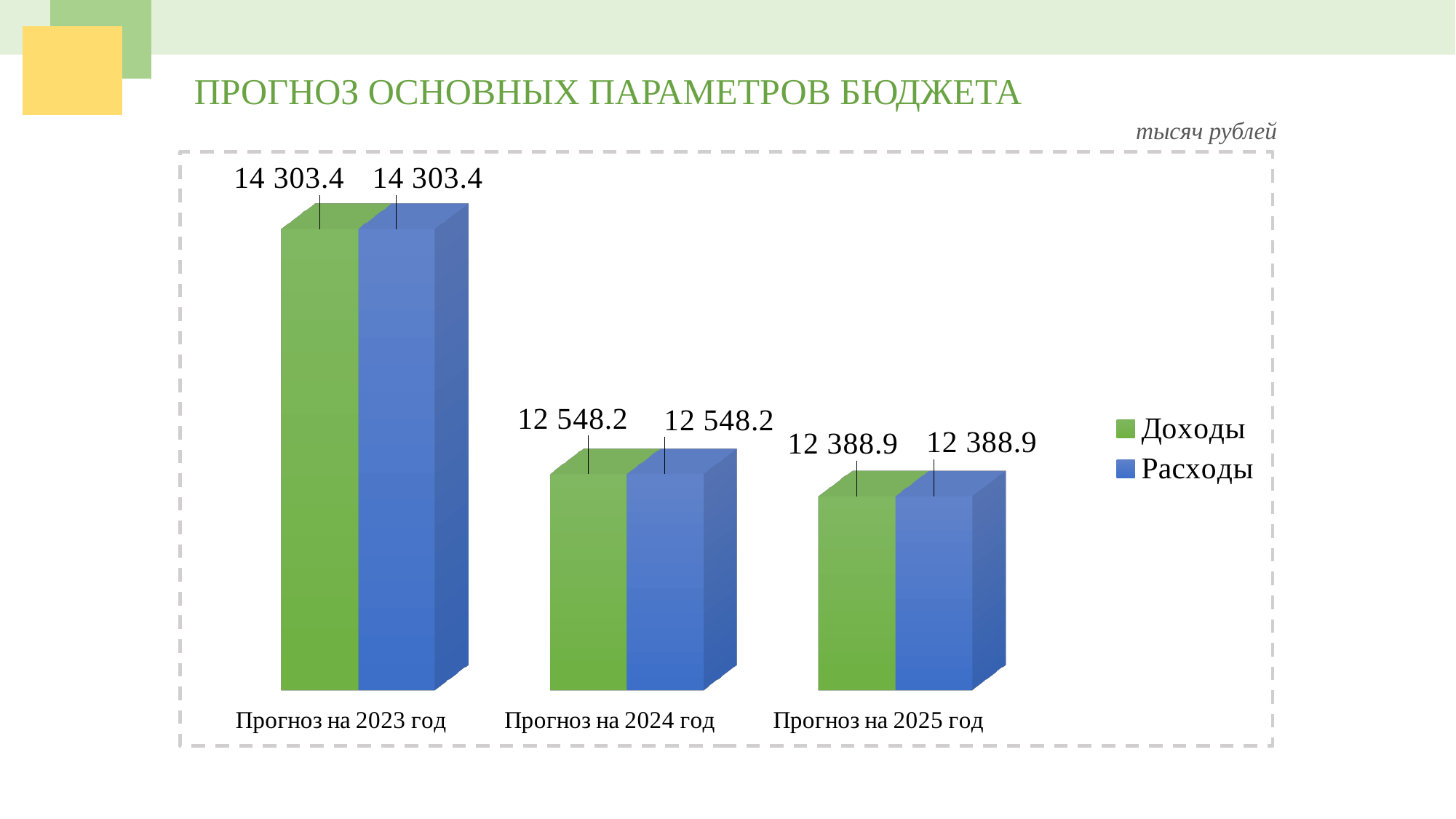
What is the difference between Расходы for Прогноз на 2024 год and Расходы for Прогноз на 2025 год? 159.3 How many categories are shown on the x axis? 3 What is the difference between Доходы for Прогноз на 2023 год and Доходы for Прогноз на 2024 год? 1 755.2 What is the value of Доходы for Прогноз на 2025 год? 12 388.9 Which is larger: Доходы for Прогноз на 2023 год or Доходы for Прогноз на 2025 год? Прогноз на 2023 год What is the value of Расходы for Прогноз на 2024 год? 12 548.2 Which category has the lowest value for Расходы? Прогноз на 2025 год How many series does the legend list? 2 Do the values for Доходы rise or fall from Прогноз на 2023 год to Прогноз на 2025 год? Fall What kind of chart is shown on the slide? Bar chart What is the value of Доходы for Прогноз на 2023 год? 14 303.4 Which category has the highest value for Доходы? Прогноз на 2023 год